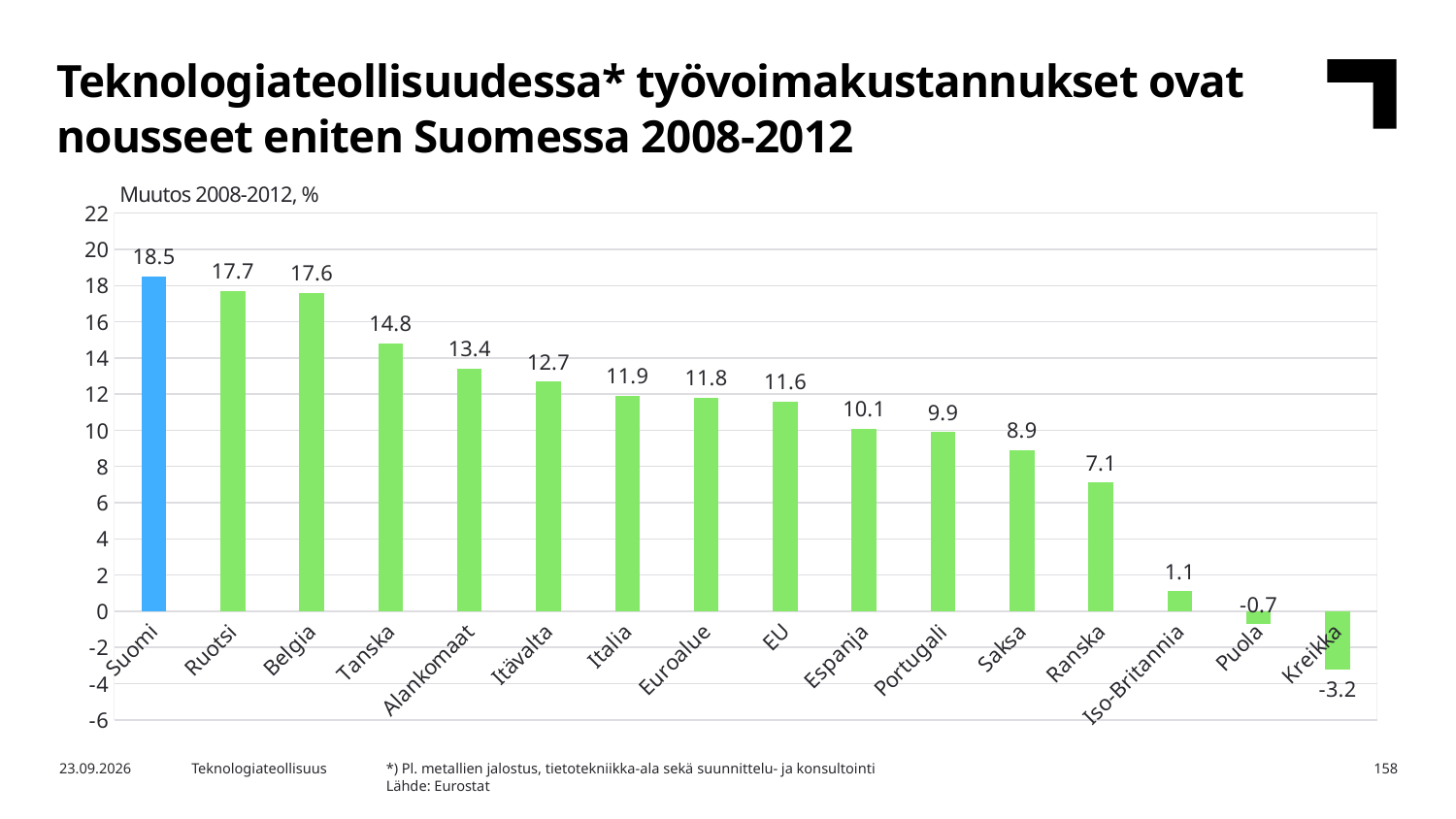
Which is larger, the value for Espanja or the value for Portugali? Espanja What is the value for Suomi? 18.5 Which country has the lowest value? Kreikka What is the difference between the values for Suomi and Ruotsi? 0.8 What is the value for Alankomaat? 13.4 Do the values rise or fall from left to right along the x axis? Fall What is the value for Kreikka? -3.2 How many countries or regions are shown on the chart? 16 Which country has the highest value? Suomi What kind of chart is shown on the slide? Bar chart What is the value for Saksa? 8.9 What is the difference between the values for Tanska and Ranska? 7.7